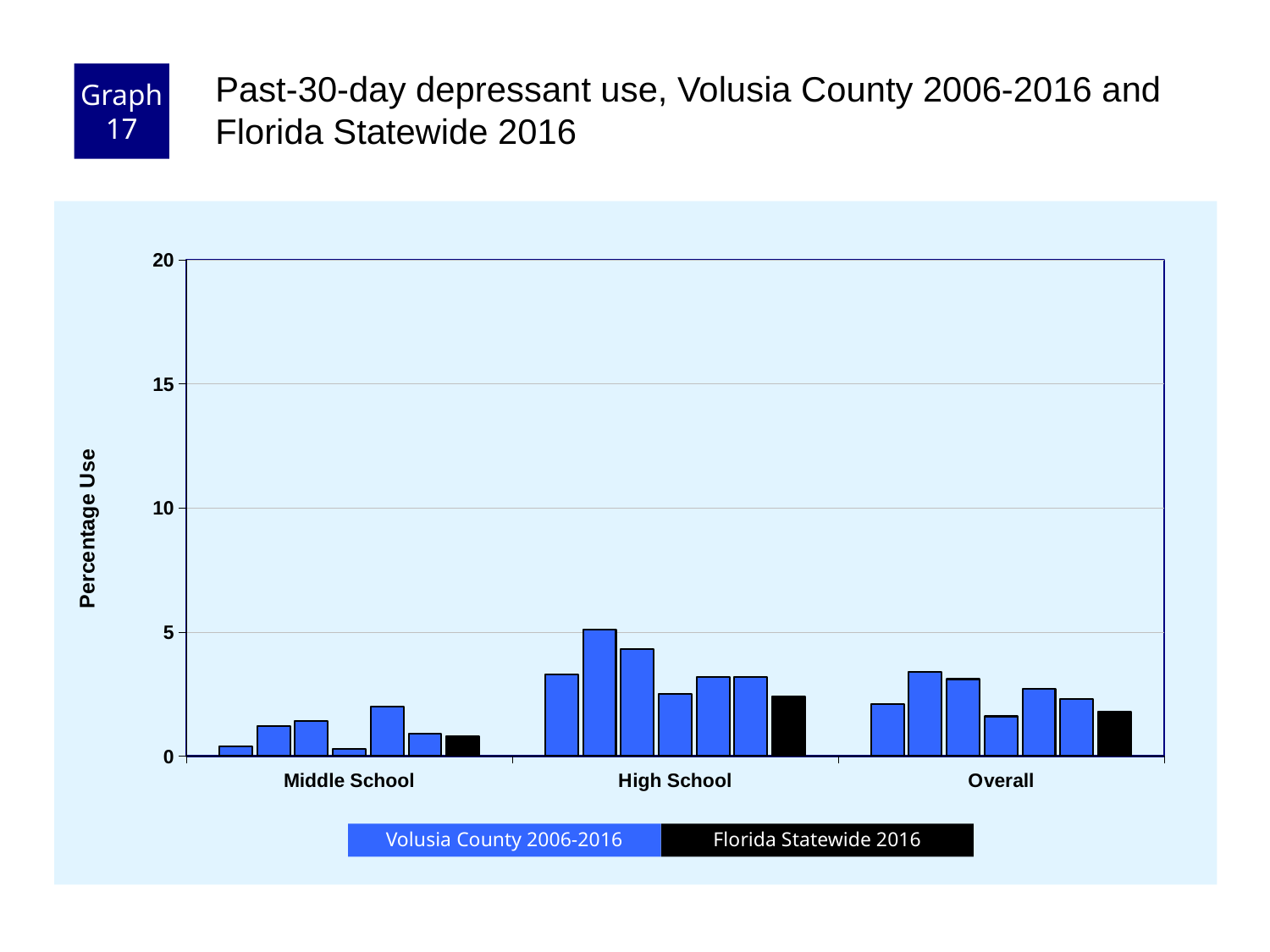
How many categories are shown on the x axis? 3 What is the label on the y axis? Percentage Use How many series does the legend list? 2 What is the title of the chart? Past-30-day depressant use, Volusia County 2006-2016 and Florida Statewide 2016 Is the Florida Statewide 2016 value for High School greater or less than 5? less Which category contains the shortest bar on the chart? Middle School Are all the Middle School bars greater or less than 5? less Is the Florida Statewide 2016 value for Overall greater or less than 5? less What kind of chart is shown on the slide? bar chart Which category contains the tallest bar on the chart? High School Which is larger, the Florida Statewide 2016 value for High School or for Middle School? High School